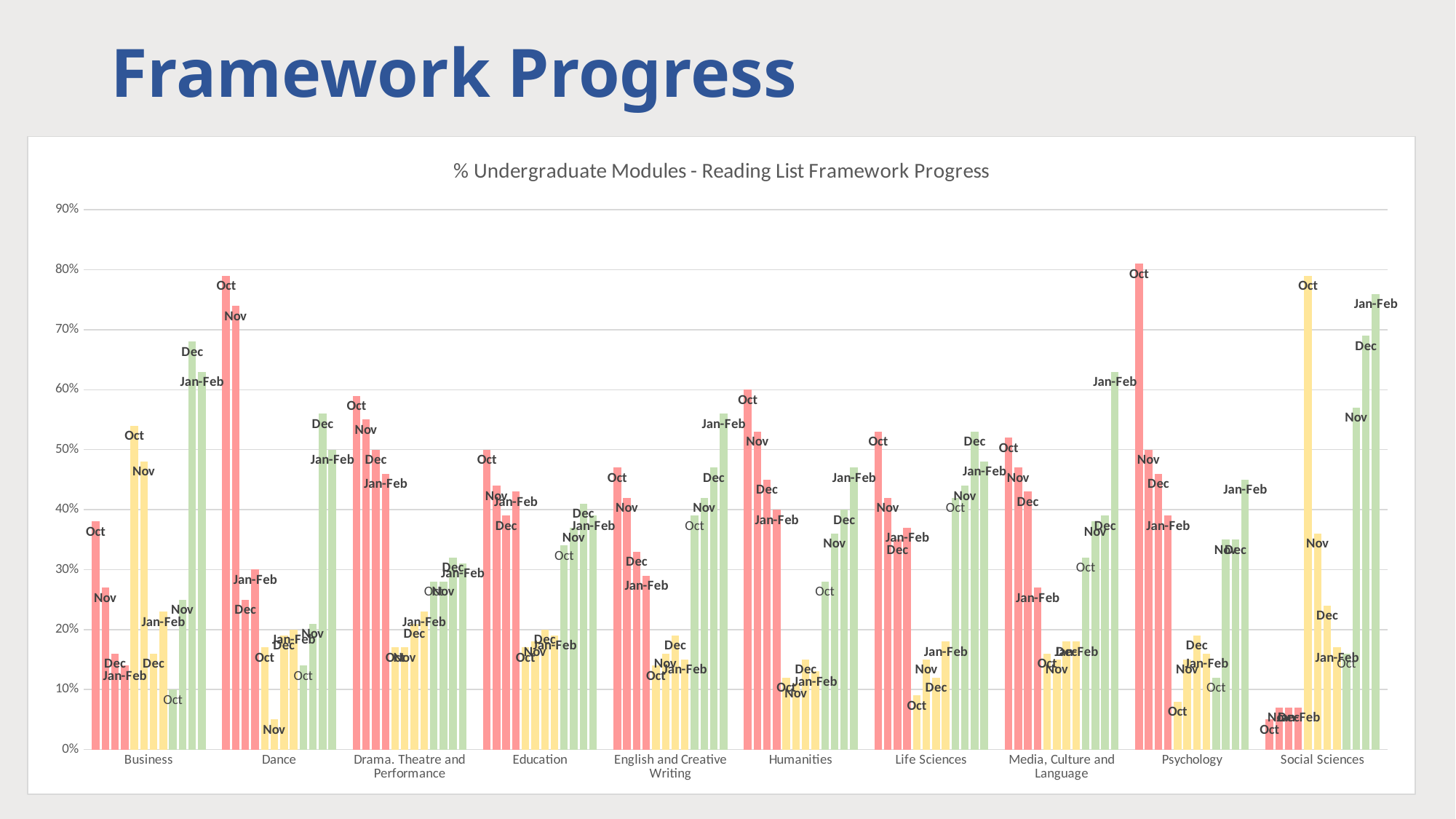
Is the yellow Oct bar for Social Sciences greater or less than 70%? greater What is the highest value shown on the y axis? 90% Is the yellow Nov bar for Dance greater or less than 10%? less Is the red Oct bar for Psychology greater or less than 70%? greater Which subject has the tallest green Jan-Feb bar? Social Sciences What kind of chart is shown on the slide? bar chart Do the red bars for Psychology rise or fall from Oct to Jan-Feb? fall How many subject categories are shown along the x axis? 10 What is the title of the chart? % Undergraduate Modules - Reading List Framework Progress Which is larger, the red Oct bar for Business or the red Oct bar for Dance? Dance